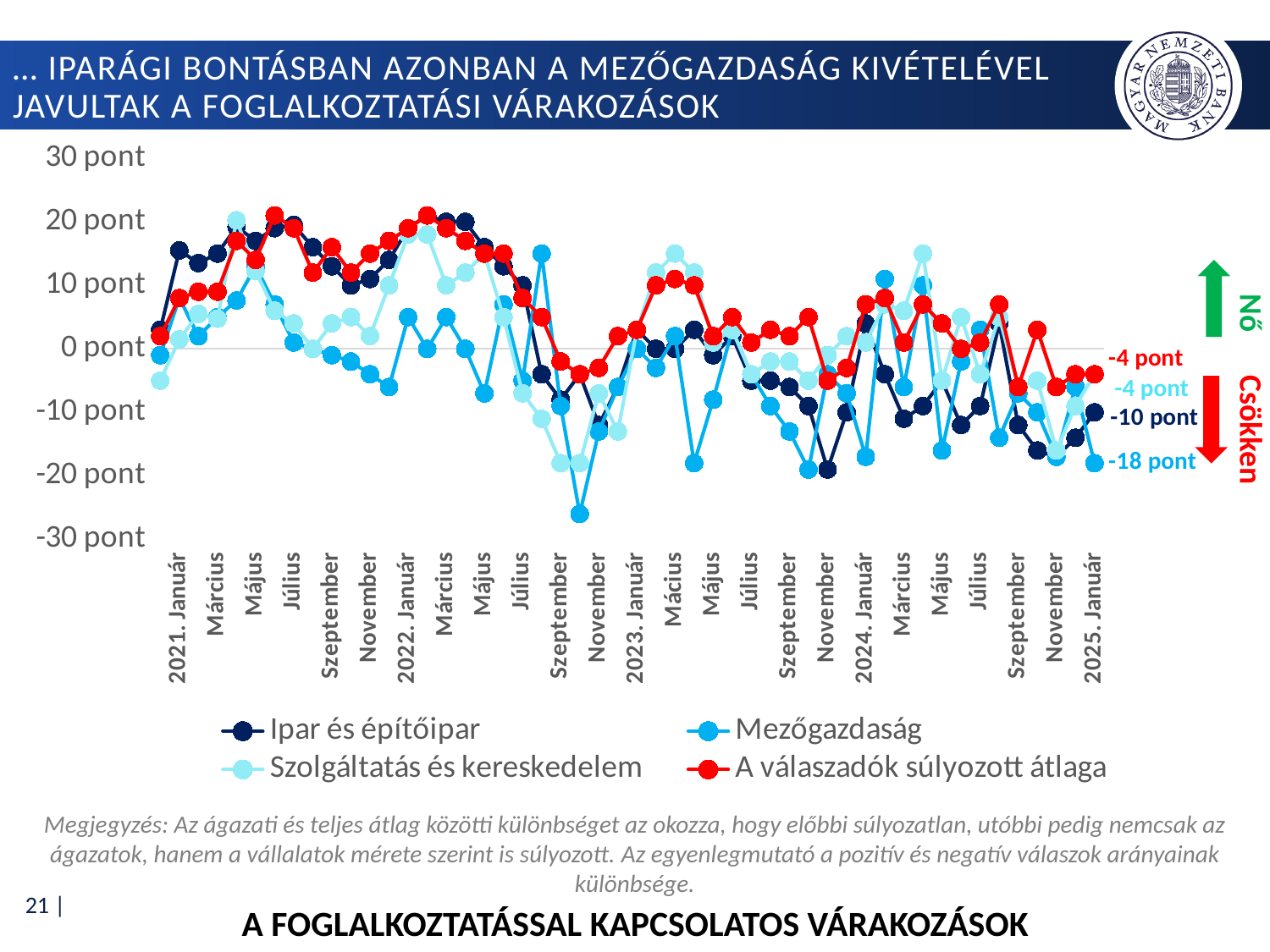
What is the difference between A válaszadók súlyozott átlaga and the Mezőgazdaság value at 2025. Január? 14 pont Which series has the lowest value at 2025. Január? Mezőgazdaság What is the value of the Ipar és építőipar series at 2025. Január, as shown by the data label? -10 pont Overall, do the values of A válaszadók súlyozott átlaga rise or fall from 2021. Január to 2025. Január? fall What is the value of A válaszadók súlyozott átlaga at 2025. Január, as shown by the data label? -4 pont What is the value of the Mezőgazdaság series at 2025. Január, as shown by the data label? -18 pont At 2025. Január, which is larger: the value for Ipar és építőipar or the value for Mezőgazdaság? Ipar és építőipar What is the title of the chart shown at the bottom of the slide? A foglalkoztatással kapcsolatos várakozások Is the lowest value of the Mezőgazdaság series (around November 2022) greater or less than -20 pont? less How many series does the legend list? 4 What kind of chart is shown on the slide? line chart What is the difference between the Ipar és építőipar value and the Mezőgazdaság value at 2025. Január? 8 pont